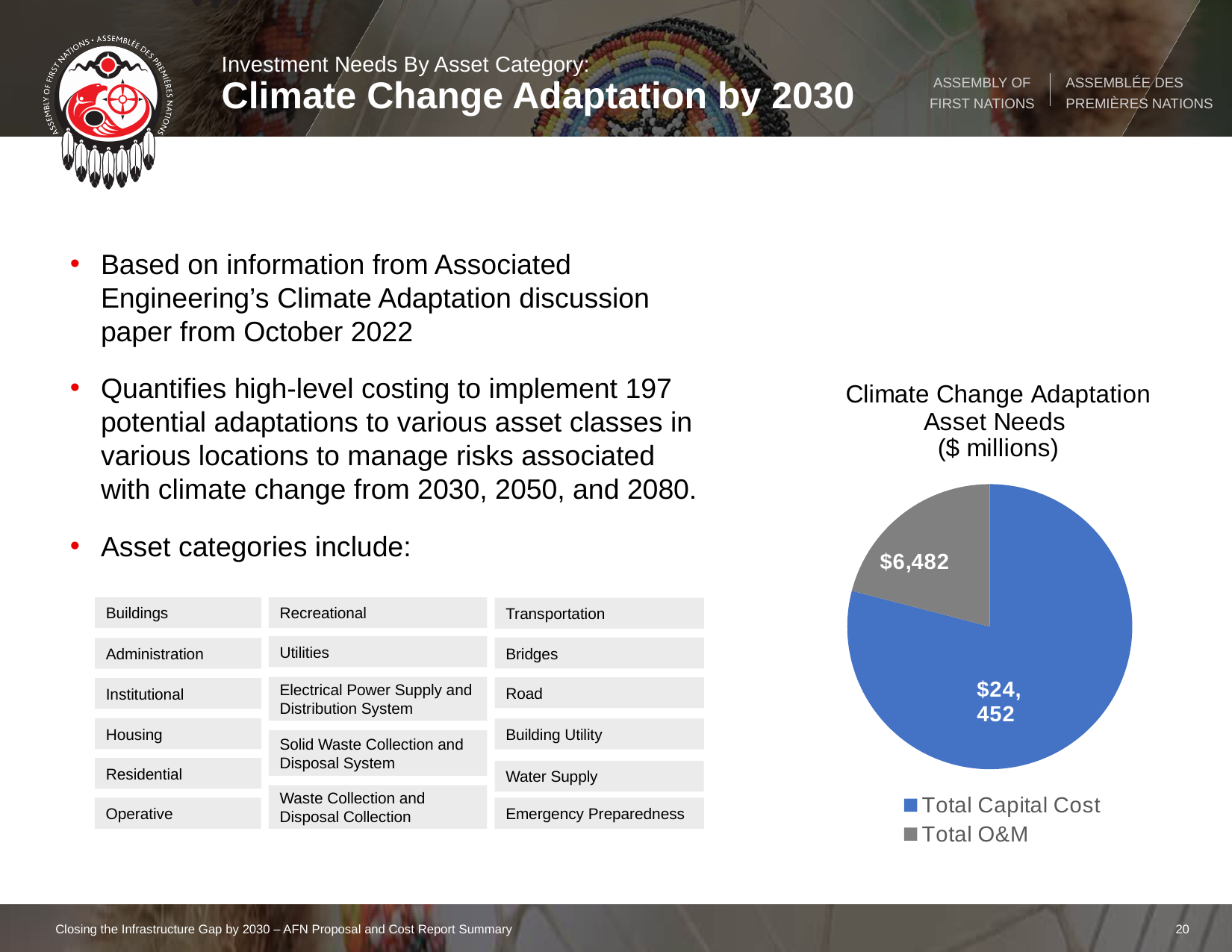
Which is larger, Total Capital Cost or Total O&M? Total Capital Cost What is the combined total of the two slices in the pie chart? $30,934 What kind of chart is shown on the slide? Pie chart How many entries does the legend of the pie chart list? 2 Which slice of the pie chart is the largest? Total Capital Cost What is the value for Total O&M in the pie chart? $6,482 What is the difference between Total Capital Cost and Total O&M in the pie chart? $17,970 Which slice of the pie chart is the smallest? Total O&M What is the value for Total Capital Cost in the pie chart? $24,452 What unit is stated in the title of the pie chart? $ millions How many slices does the pie chart have? 2